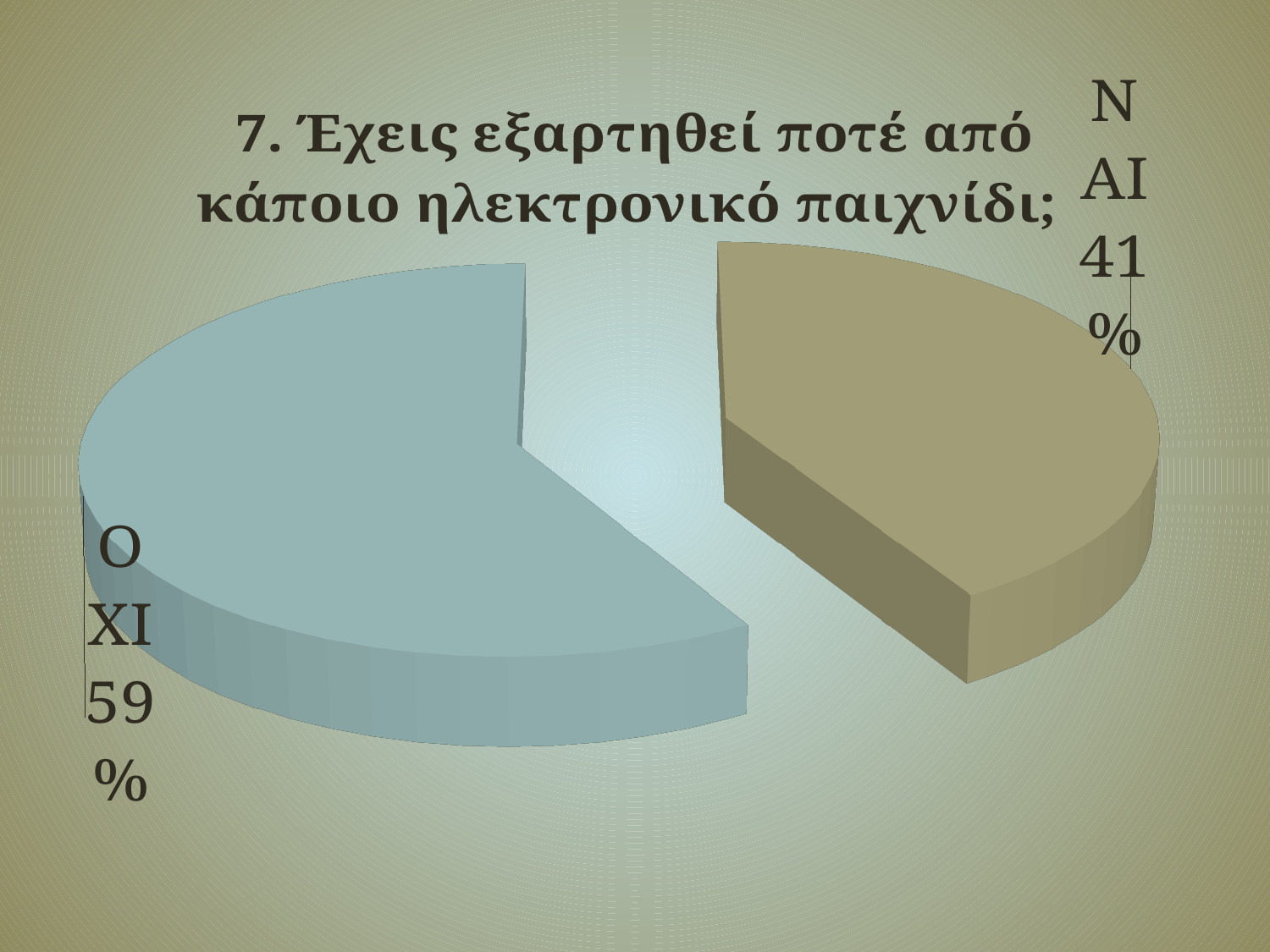
How many slices does the pie chart have? 2 What kind of chart is shown on the slide? pie chart What is the title of the chart? 7. Έχεις εξαρτηθεί ποτέ από κάποιο ηλεκτρονικό παιχνίδι; What is the difference in percentage points between ΟΧΙ and ΝΑΙ? 18 What colour is the ΟΧΙ slice? light blue What percentage is shown for ΟΧΙ? 59% Which is larger, ΝΑΙ or ΟΧΙ? ΟΧΙ What share of the pie does the ΝΑΙ slice represent? 41% What percentage is shown for ΝΑΙ? 41% Which slice is the largest? ΟΧΙ Which slice is the smallest? ΝΑΙ